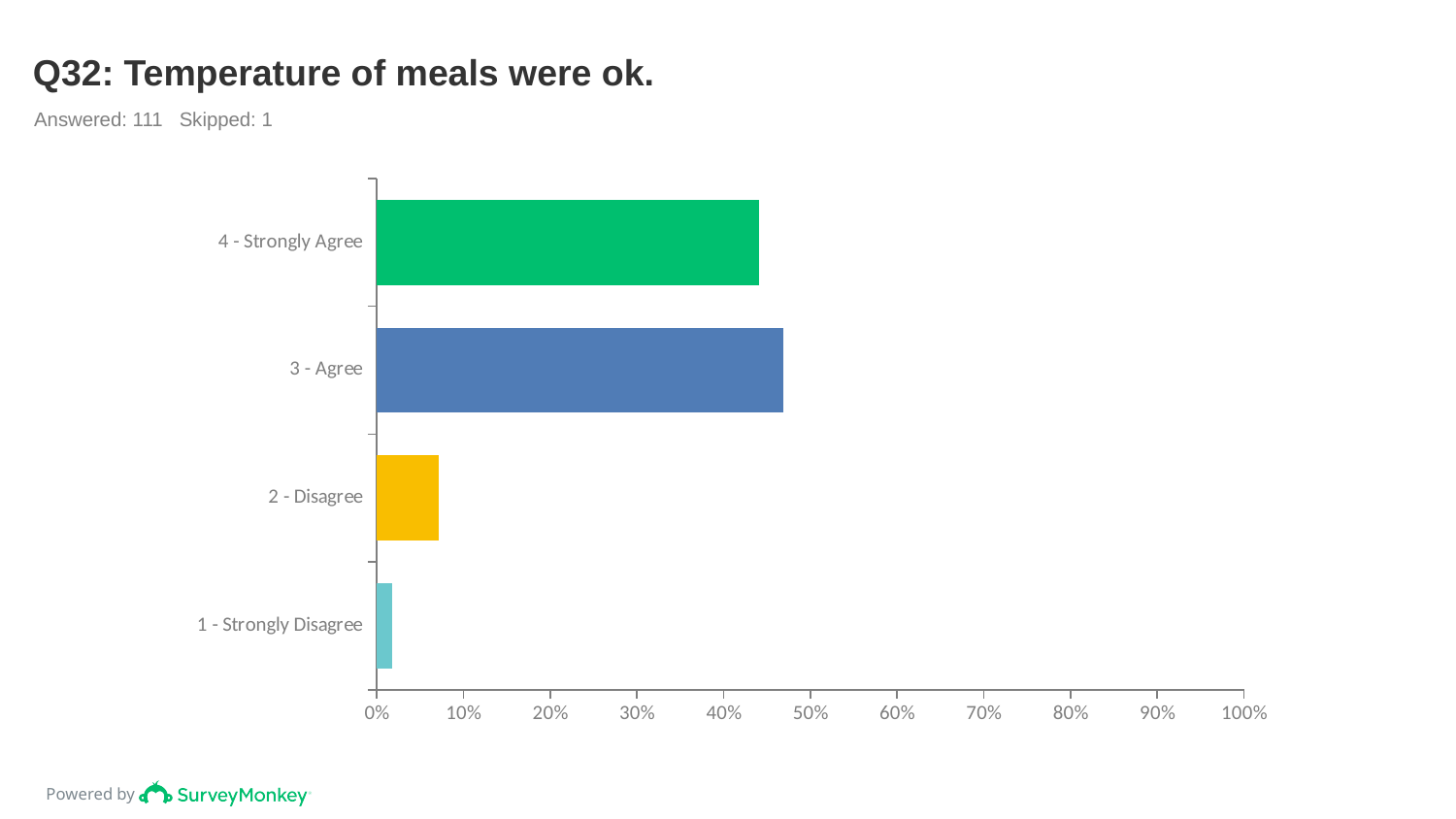
What is the title of the chart? Q32: Temperature of meals were ok. Which is larger, the value for 2 - Disagree or the value for 1 - Strongly Disagree? 2 - Disagree Is the value for 4 - Strongly Agree greater or less than 50%? less Is the value for 1 - Strongly Disagree greater or less than 10%? less Which is larger, the value for 3 - Agree or the value for 2 - Disagree? 3 - Agree How many categories are plotted in the chart? 4 Which category has the lowest value? 1 - Strongly Disagree How many respondents answered this question according to the slide? 111 What kind of chart is shown on the slide? bar chart Is the value for 4 - Strongly Agree greater or less than 40%? greater